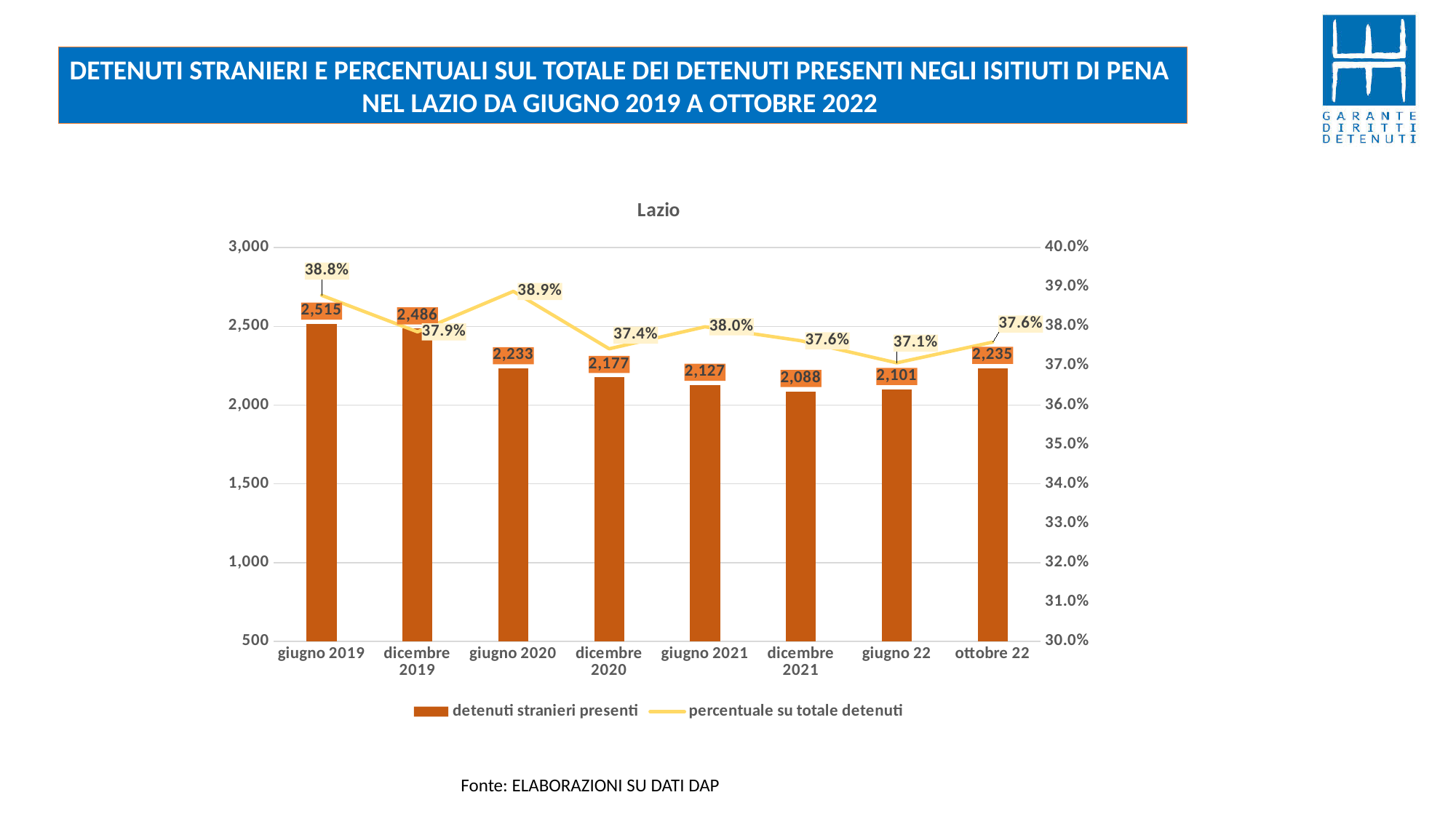
Which is larger, the number of 'detenuti stranieri presenti' in giugno 22 or in ottobre 22? ottobre 22 What is the title shown above the chart? Lazio What is the value of 'detenuti stranieri presenti' for giugno 2019? 2,515 What is the 'percentuale su totale detenuti' for giugno 2020? 38.9% What is the 'percentuale su totale detenuti' for ottobre 22? 37.6% Which period has the lowest 'percentuale su totale detenuti'? giugno 22 How many series does the legend list? 2 Which period has the highest number of 'detenuti stranieri presenti'? giugno 2019 What is the difference in 'detenuti stranieri presenti' between giugno 2019 and dicembre 2021? 427 How many periods are shown on the x axis of the chart? 8 What is the value of 'detenuti stranieri presenti' for dicembre 2021? 2,088 What kind of chart is shown on the slide? Combined bar and line chart